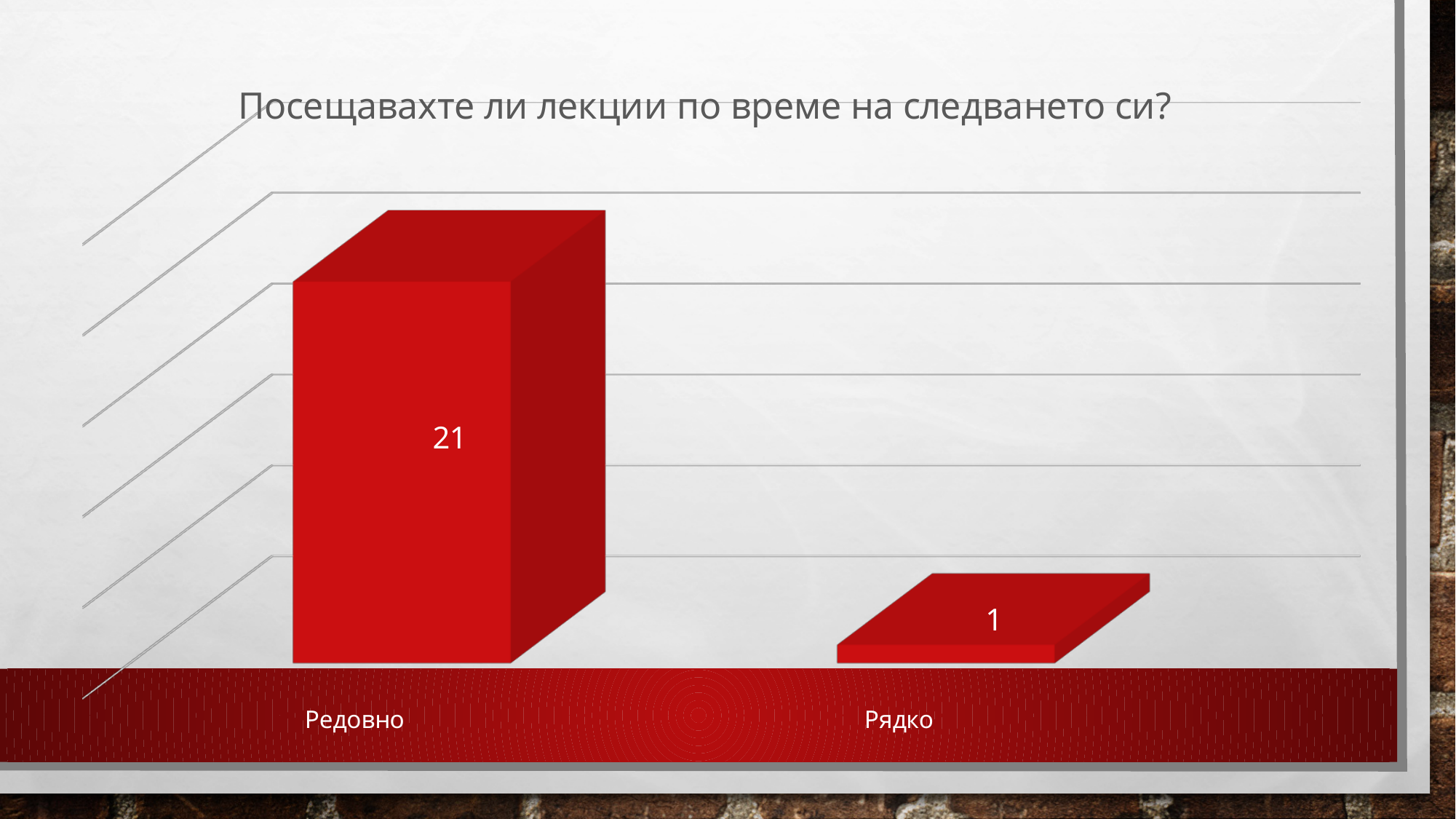
Which is larger, the value for Редовно or the value for Рядко? Редовно How many categories are shown in the chart? 2 Which category has the highest value? Редовно What is the value for Рядко? 1 What colour are the bars in the chart? Red What kind of chart is shown on the slide? Bar chart What is the total of the two values shown in the chart? 22 What is the title of the chart? Посещавахте ли лекции по време на следването си? What is the difference between the values for Редовно and Рядко? 20 What is the value for Редовно? 21 Which category has the lowest value? Рядко